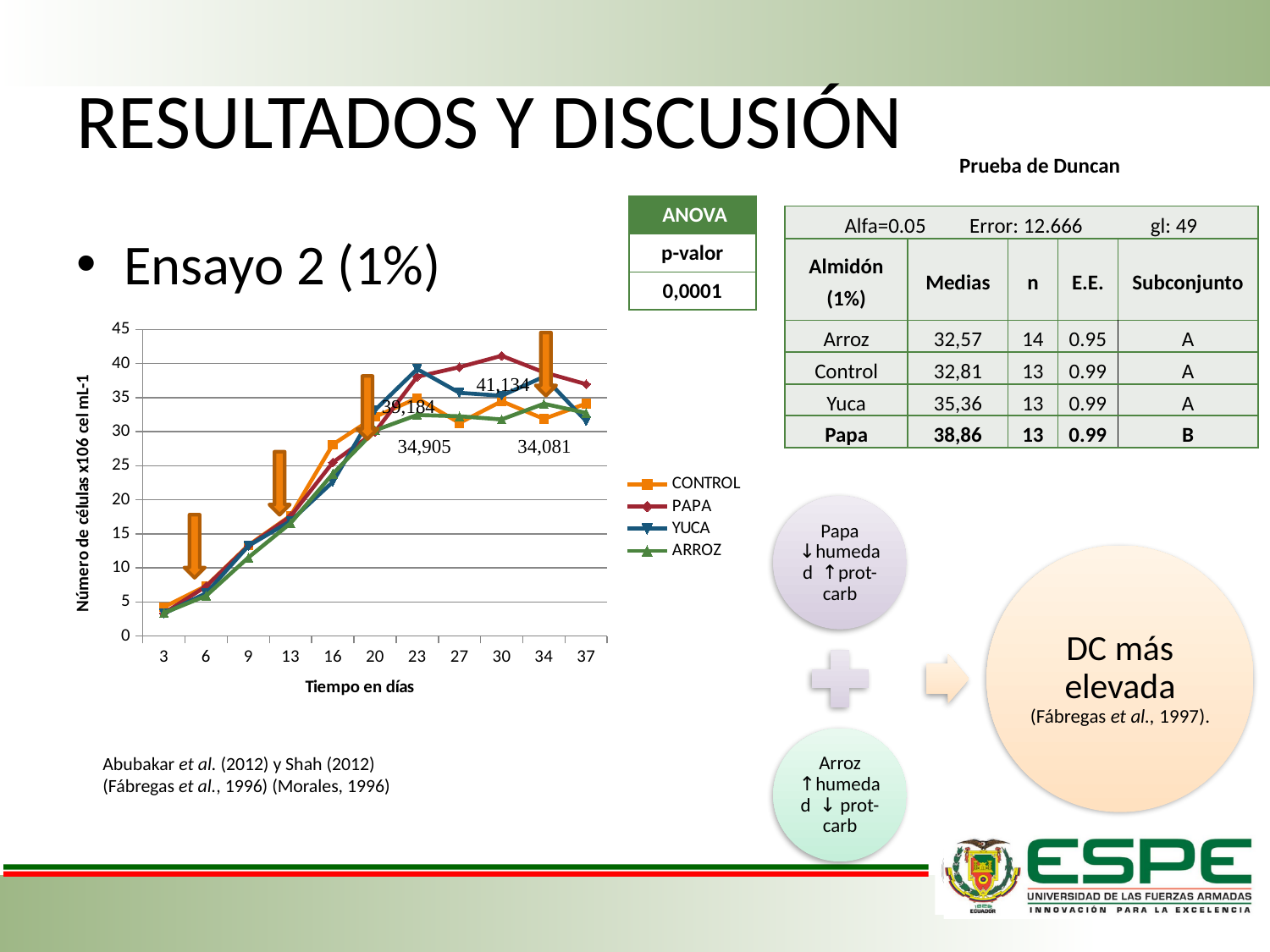
Is the value for YUCA at day 23 greater or less than 35? greater Is the value for CONTROL at day 16 greater or less than 25? greater Is the value for PAPA at day 30 greater or less than 40? greater Which series are listed in the chart legend? CONTROL, PAPA, YUCA, ARROZ Do the values for PAPA rise or fall between day 3 and day 23? rise What is the title of the x axis of the chart? Tiempo en días How many time points are plotted along the x axis of the chart? 11 Which series has the highest value at day 30? PAPA What kind of chart is shown on the slide? line chart How many series does the chart legend list? 4 At day 30, which is larger, the value for PAPA or the value for ARROZ? PAPA